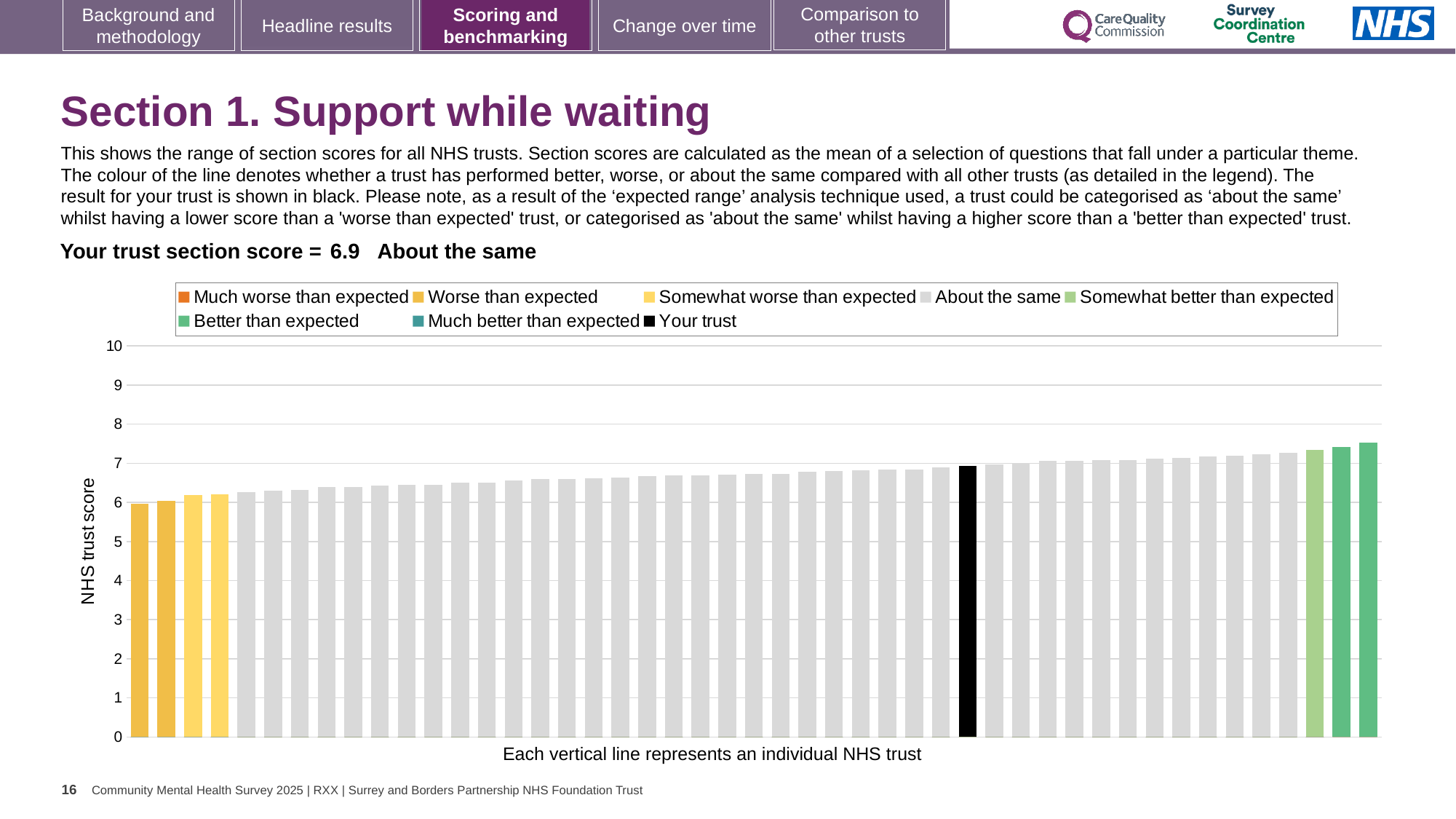
Is the value for your trust (the black bar) greater or less than 7? less Which category does your trust's section score fall into according to the slide? About the same What kind of chart is shown on the slide? bar chart Is the value of the shortest bar in the chart greater or less than 5? greater Do the bar values rise or fall from left to right along the x axis? rise What is the section score for your trust shown on the slide? 6.9 What is the label on the y axis of the chart? NHS trust score Is the value for your trust (the black bar) greater or less than 6? greater How many bars are coloured as 'Better than expected' (green)? 2 What colour is the bar representing your trust? black How many entries does the chart legend list? 8